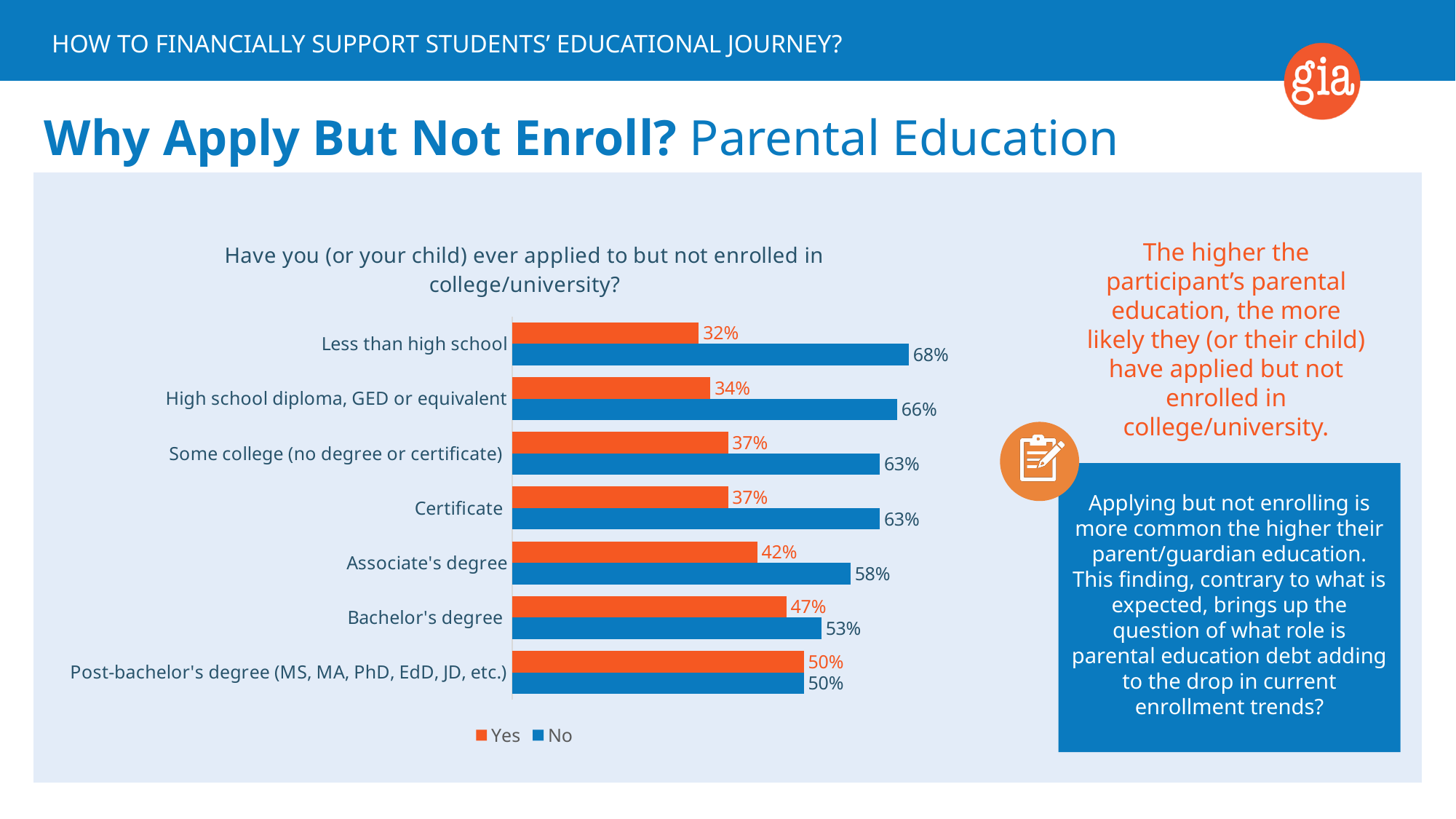
What kind of chart is shown on the slide? Bar chart What is the 'Yes' value for Less than high school? 32% How many parental education categories are shown in the chart? 7 Which category has the highest 'Yes' value? Post-bachelor's degree (MS, MA, PhD, EdD, JD, etc.) How many series does the legend list? 2 Do the 'Yes' values rise or fall as parental education increases from Less than high school to Post-bachelor's degree? Rise Which colour represents the 'No' series in the chart? Blue What is the 'No' value for Associate's degree? 58% What is the difference between the 'No' and 'Yes' values for Less than high school? 36% Which category has the lowest 'Yes' value? Less than high school What is the 'Yes' value for Bachelor's degree? 47% Which is larger for Associate's degree, the 'Yes' value or the 'No' value? No